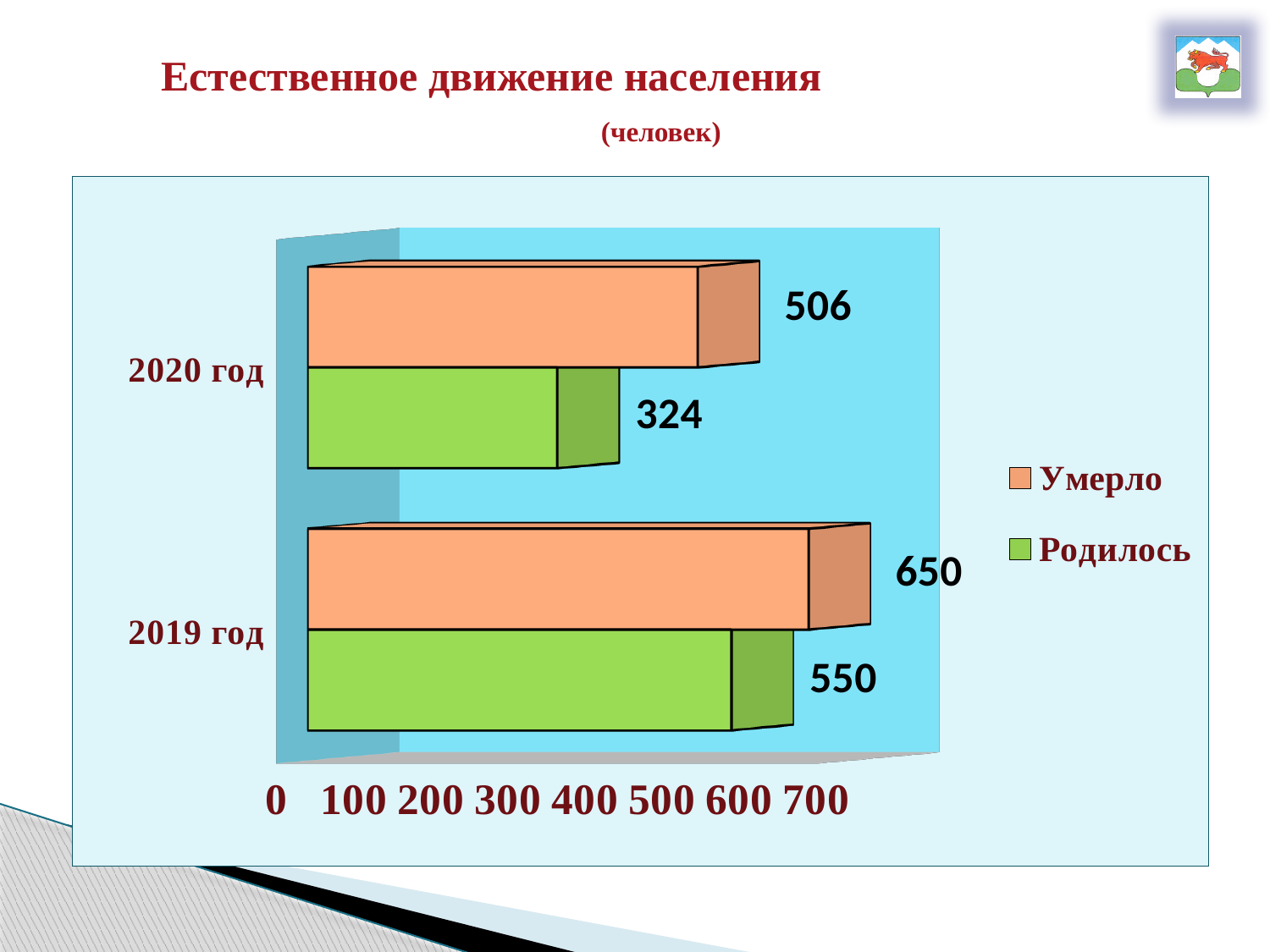
What is the value for Родилось in 2020 год? 324 What is the value for Умерло in 2020 год? 506 Which is larger in 2019 год: Умерло or Родилось? Умерло Which series has the lowest value in 2020 год? Родилось What is the title of the chart? Естественное движение населения (человек) What is the difference between Умерло and Родилось in 2020 год? 182 What kind of chart is shown on the slide? Bar chart What is the difference between Умерло in 2019 год and Умерло in 2020 год? 144 What is the value for Родилось in 2019 год? 550 Which year has the higher value for Родилось? 2019 год How many series does the legend list? 2 What is the value for Умерло in 2019 год? 650